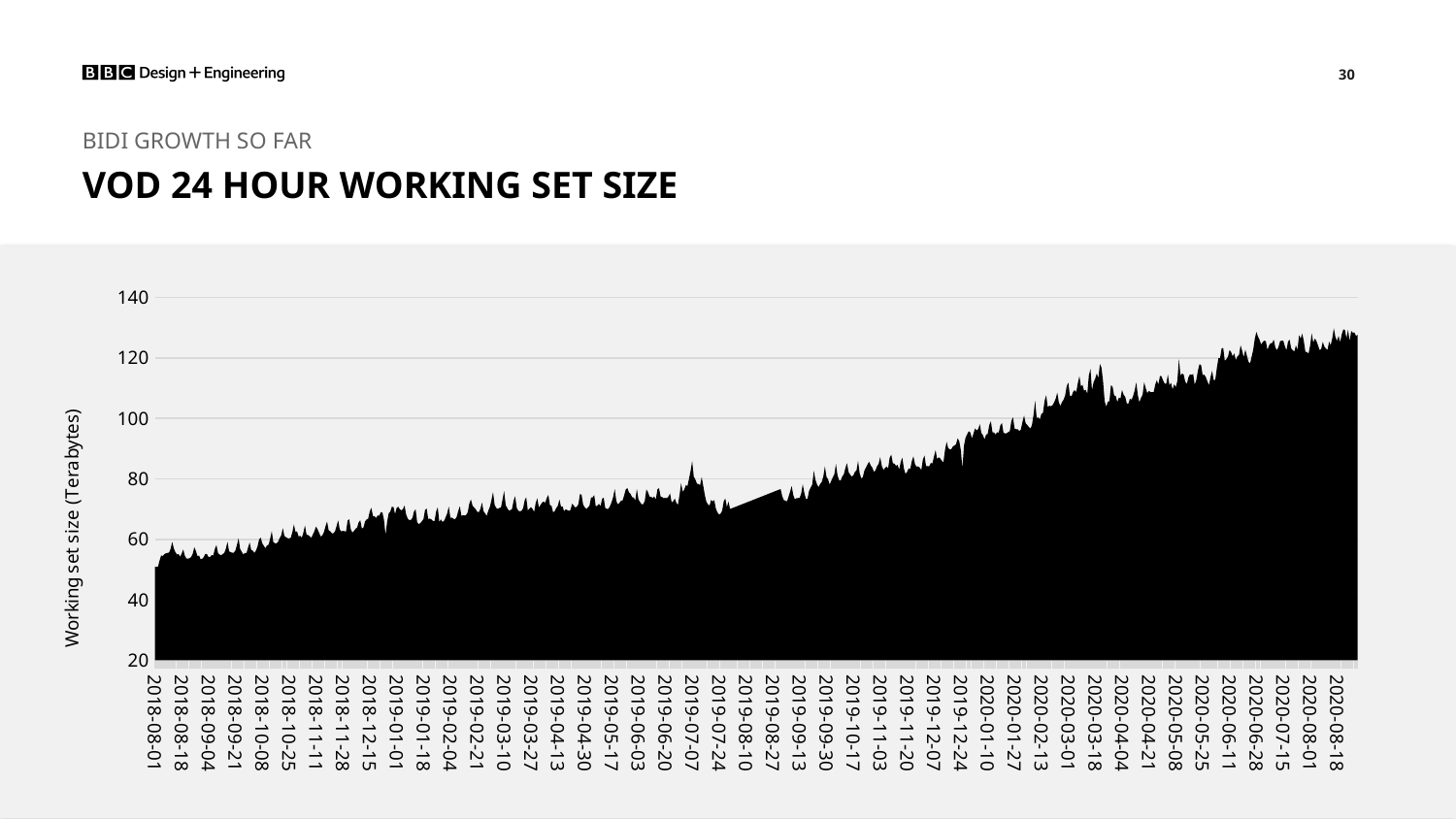
Does the working set size generally rise or fall from 2018-08-01 to 2020-08-18? Rise Which is larger, the working set size at 2018-08-01 or at 2020-08-18? 2020-08-18 Is the working set size at 2020-08-18 greater or less than 120 terabytes? greater What is the title of the chart on the slide? VOD 24 HOUR WORKING SET SIZE What kind of chart is shown on the slide? Area chart Is the working set size at 2019-04-13 greater or less than 80 terabytes? less Is the working set size at 2019-01-01 greater or less than 60 terabytes? greater Around which part of the date range is the working set size at its lowest? The start, around 2018-08-01 What is the highest value shown on the vertical axis of the chart? 140 What is the label on the vertical axis of the chart? Working set size (Terabytes)